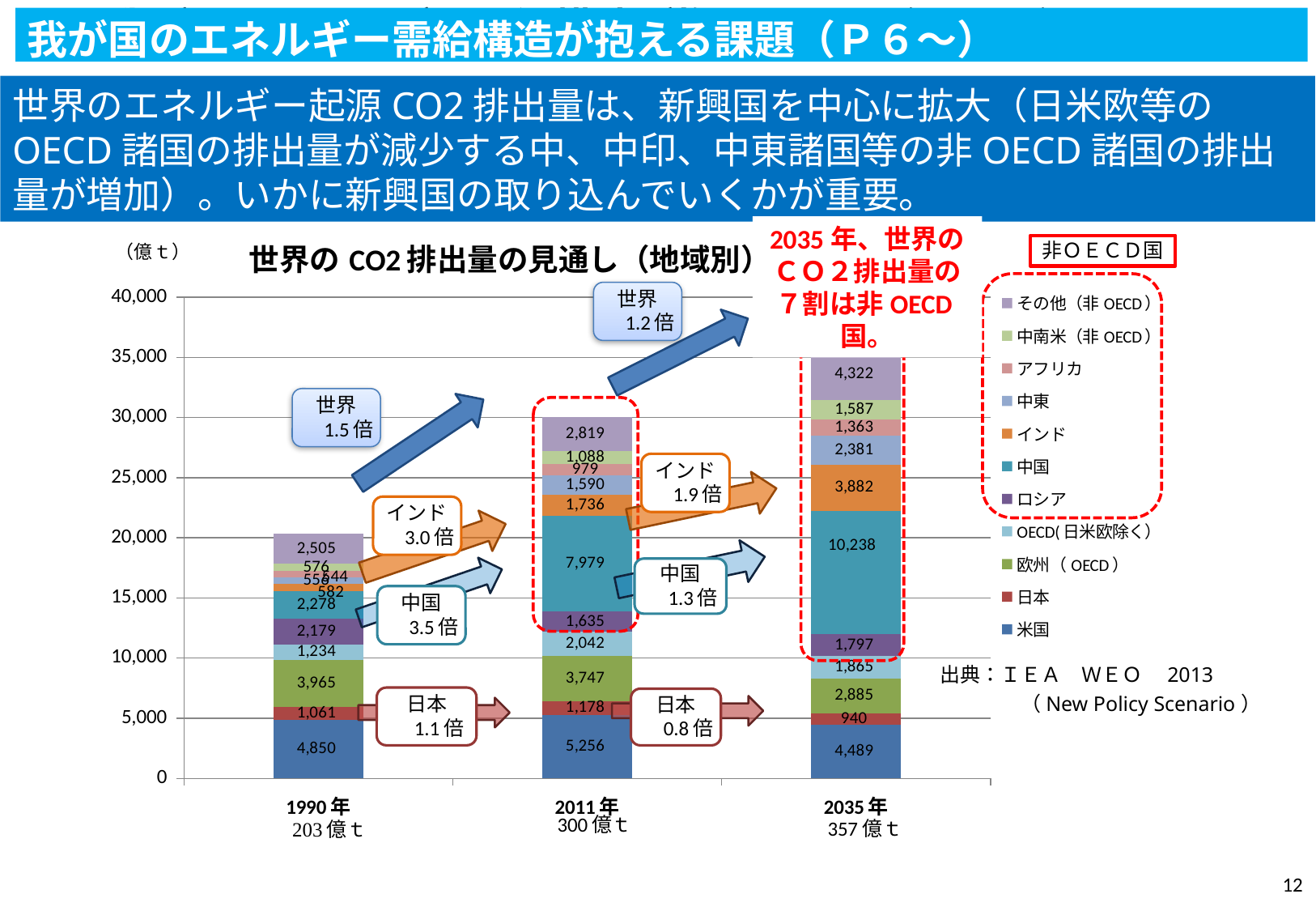
Does the total world CO2 emission rise or fall from 1990 to 2035 along the x axis? Rise What is the value for 中国 in 2011? 7,979 What is the value for 米国 in 1990? 4,850 Which is larger, the 米国 value in 2011 or the 米国 value in 2035? 2011 (5,256) What is the value for 日本 in 2035? 940 What is the total of the 2035 bar as printed on the slide? 357億t What is the value for インド in 2035? 3,882 Which region has the largest segment in the 2035 bar? 中国 What type of chart is shown on the slide? Stacked bar chart What is the difference between the 中国 values in 2035 and 2011? 2,259 How many years (categories) are shown on the x axis of the chart? 3 How many series does the chart legend list? 11